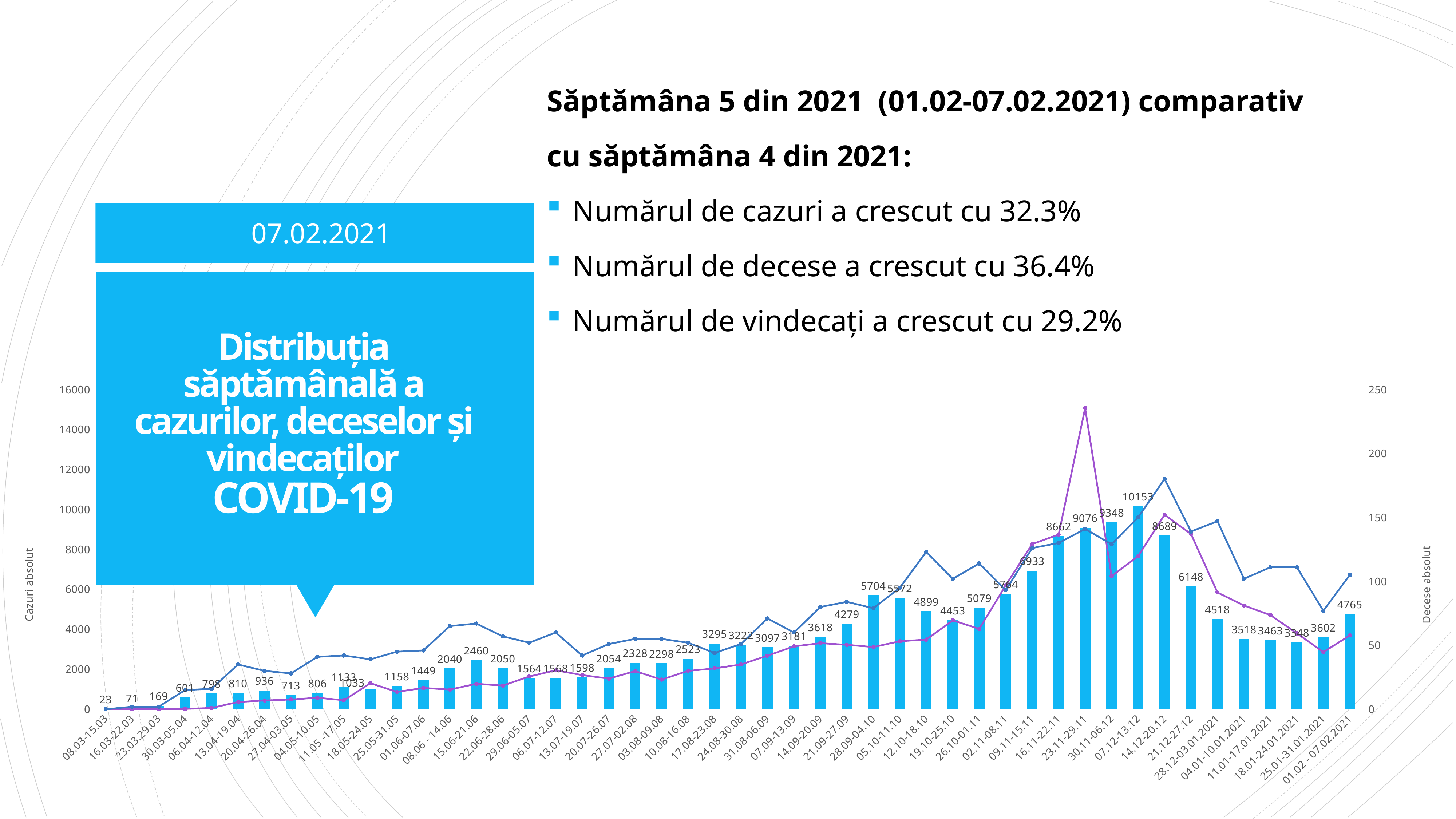
What is the value of the bar for the week 01.02 - 07.02.2021? 4765 Which week has the lowest bar value? 08.03-15.03 What is the value of the bar for the week 07.12-13.12? 10153 What is the title of the right vertical axis? Decese absolut Which bar is larger: 28.09-04.10 or 05.10-11.10? 28.09-04.10 What is the difference between the bar values for 07.12-13.12 and 30.11-06.12? 805 What is the title of the left vertical axis? Cazuri absolut Which week has the highest bar value? 07.12-13.12 What is the difference between the bar values for 01.02 - 07.02.2021 and 25.01-31.01.2021? 1163 What is the value of the bar for the week 08.03-15.03? 23 What is the value of the bar for the week 16.11-22.11? 8662